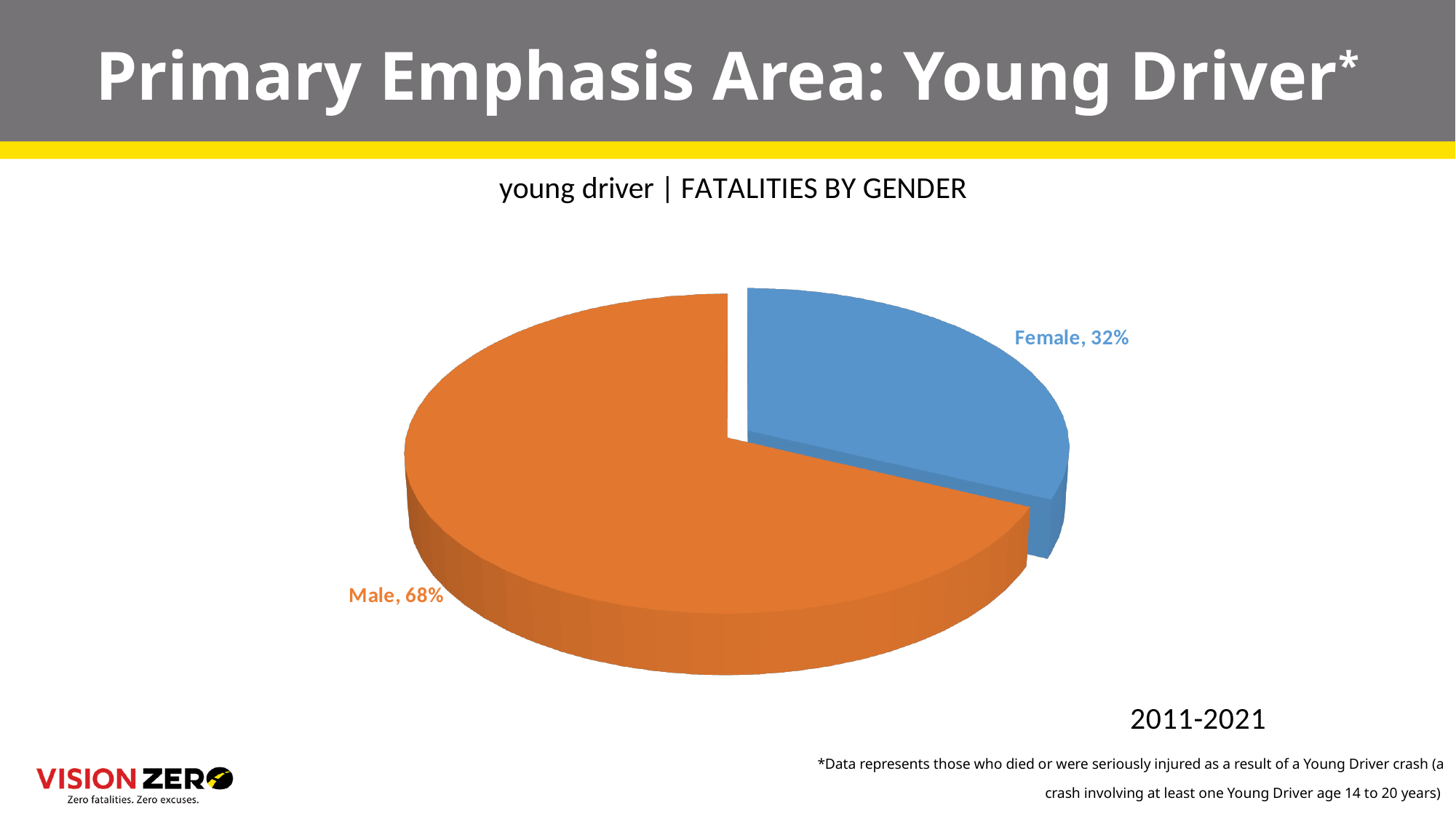
What time period does the chart cover? 2011-2021 What is the difference in percentage points between the Male and Female shares? 36 Which gender has the smaller share of young driver fatalities? Female What is the title of the chart? young driver | FATALITIES BY GENDER Which gender has the larger share of young driver fatalities? Male What percentage of young driver fatalities are Male? 68% What kind of chart is shown on the slide? pie chart What colour is the Female slice of the pie chart? blue How many slices does the pie chart have? 2 What percentage of young driver fatalities are Female? 32% Is the Male share larger or smaller than the Female share? larger